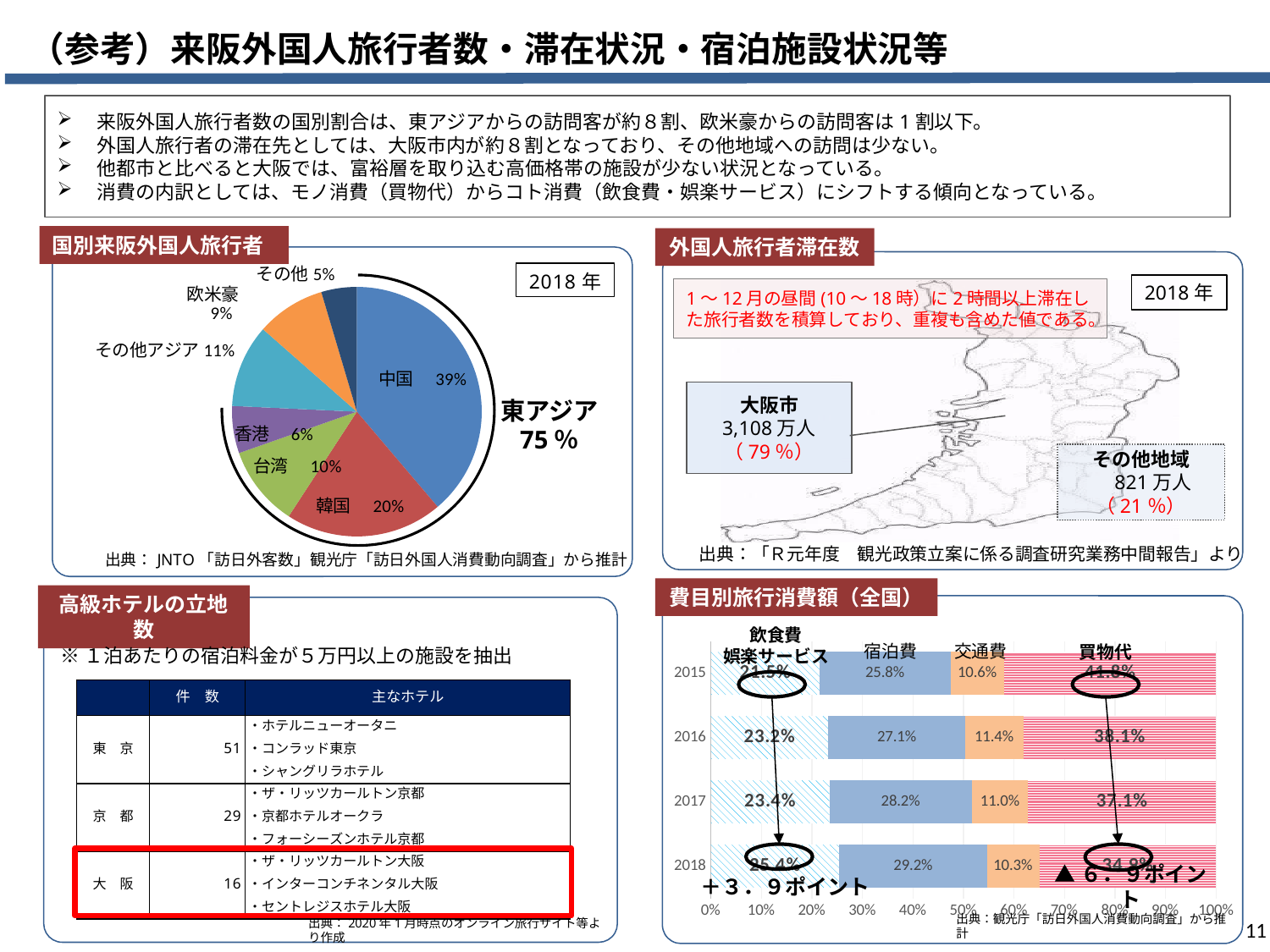
In the 費目別旅行消費額（全国） chart, what is the value of 宿泊費 for 2017? 28.2% In the 国別来阪外国人旅行者 pie chart, what is the difference in percentage points between 台湾 and 香港? 4 In the 国別来阪外国人旅行者 pie chart, which category has the largest share? 中国 In the 国別来阪外国人旅行者 pie chart, what share does 中国 have? 39% In the 費目別旅行消費額（全国） chart, what is the value of 買物代 for 2016? 38.1% In the 国別来阪外国人旅行者 pie chart, which category has the smallest share? その他 What kind of chart is the 国別来阪外国人旅行者 chart? pie chart In the 費目別旅行消費額（全国） chart, does the 宿泊費 share rise or fall from 2015 to 2018? rise In the 費目別旅行消費額（全国） chart, how many series are shown? 4 In the 国別来阪外国人旅行者 pie chart, what share does 韓国 have? 20% In the 国別来阪外国人旅行者 pie chart, which is larger, その他アジア or 欧米豪? その他アジア In the 国別来阪外国人旅行者 pie chart, how many slices are there? 7